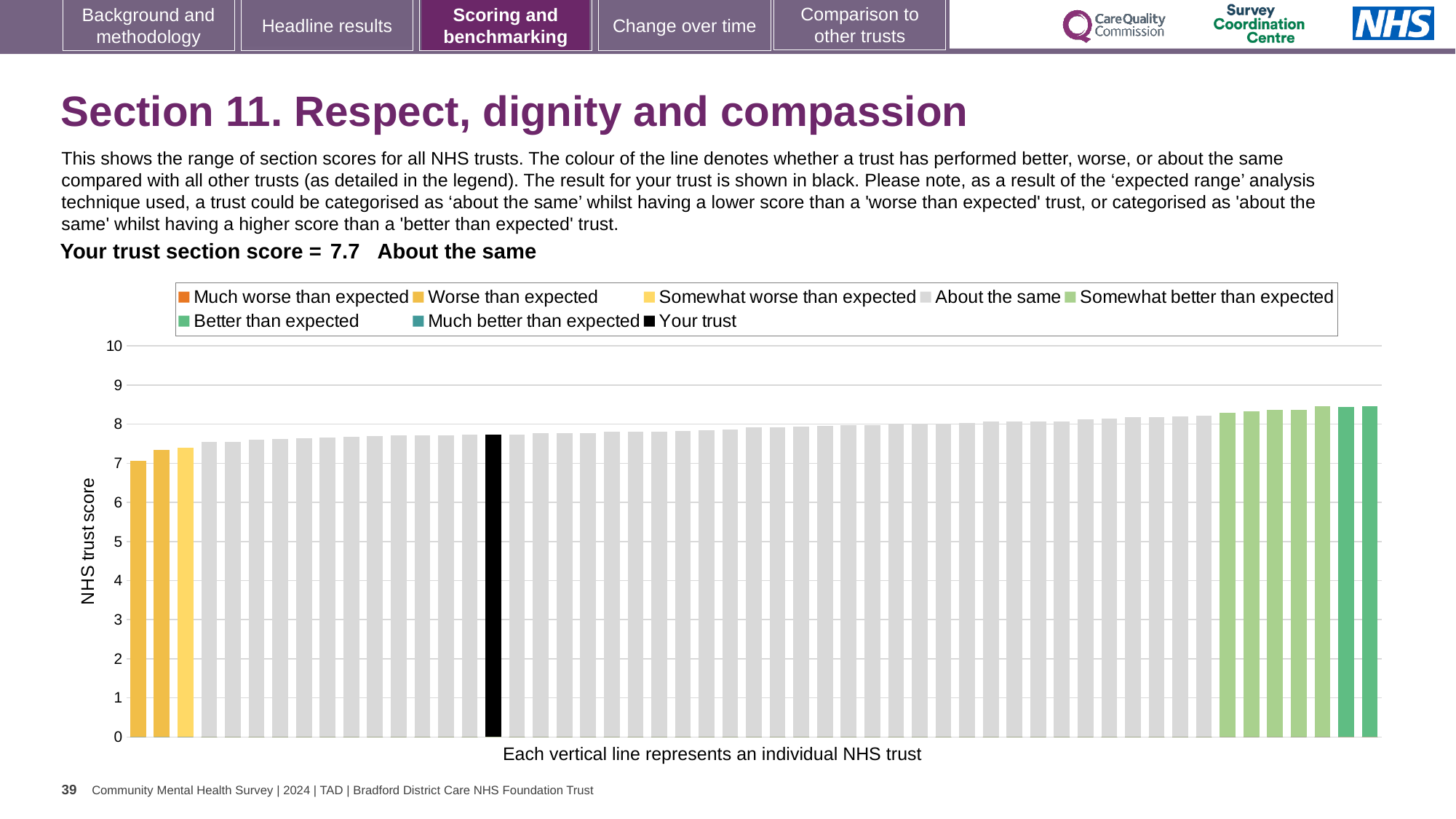
Do the trust scores rise or fall from left to right along the x axis? rise Which is larger, the value of the rightmost bar or the value of the leftmost bar? the rightmost bar What colour is used for the bar representing your trust? black Is the value for the leftmost bar greater or less than 8? less Which category does your trust fall into according to the slide? About the same Is the value for the rightmost bar greater or less than 8? greater What is the label on the y axis of the chart? NHS trust score What is the section score for your trust shown on the slide? 7.7 What kind of chart is shown on the slide? bar chart Is the value for the rightmost bar greater or less than 9? less How many entries does the chart legend list? 8